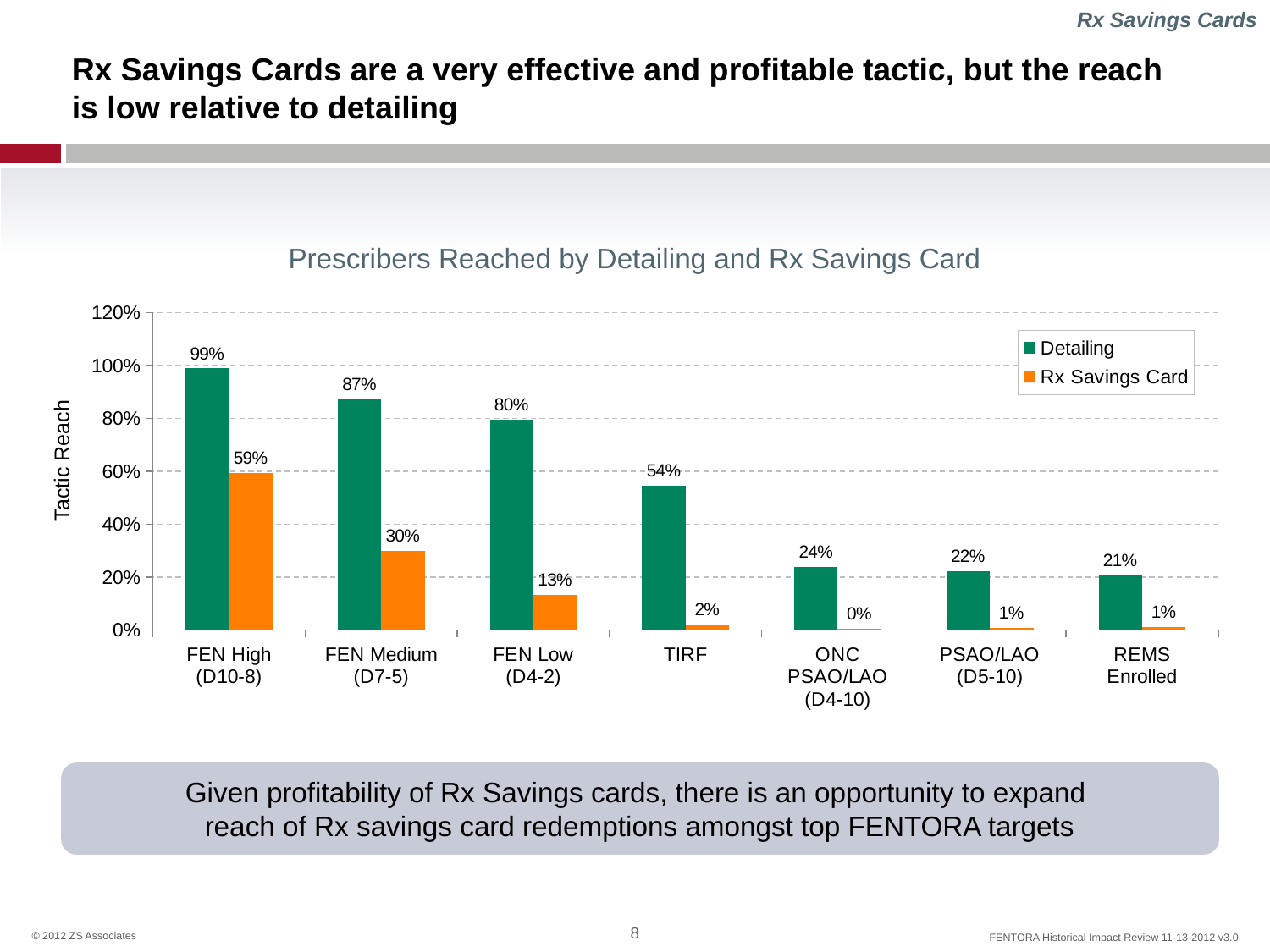
Which is larger for TIRF: the Detailing reach or the Rx Savings Card reach? Detailing Which category has the highest Detailing reach? FEN High (D10-8) What is the Detailing reach for FEN High (D10-8)? 99% What is the difference between Detailing and Rx Savings Card reach for FEN Low (D4-2)? 67% Which category has the lowest Detailing reach? REMS Enrolled What kind of chart is shown on the slide? Bar chart Do the Detailing values rise or fall moving from FEN High (D10-8) to REMS Enrolled along the x axis? Fall How many series does the legend list? 2 How many categories are shown on the x axis? 7 What is the Rx Savings Card reach for FEN Medium (D7-5)? 30% What is the title of the chart? Prescribers Reached by Detailing and Rx Savings Card What is the Rx Savings Card reach for ONC PSAO/LAO (D4-10)? 0%